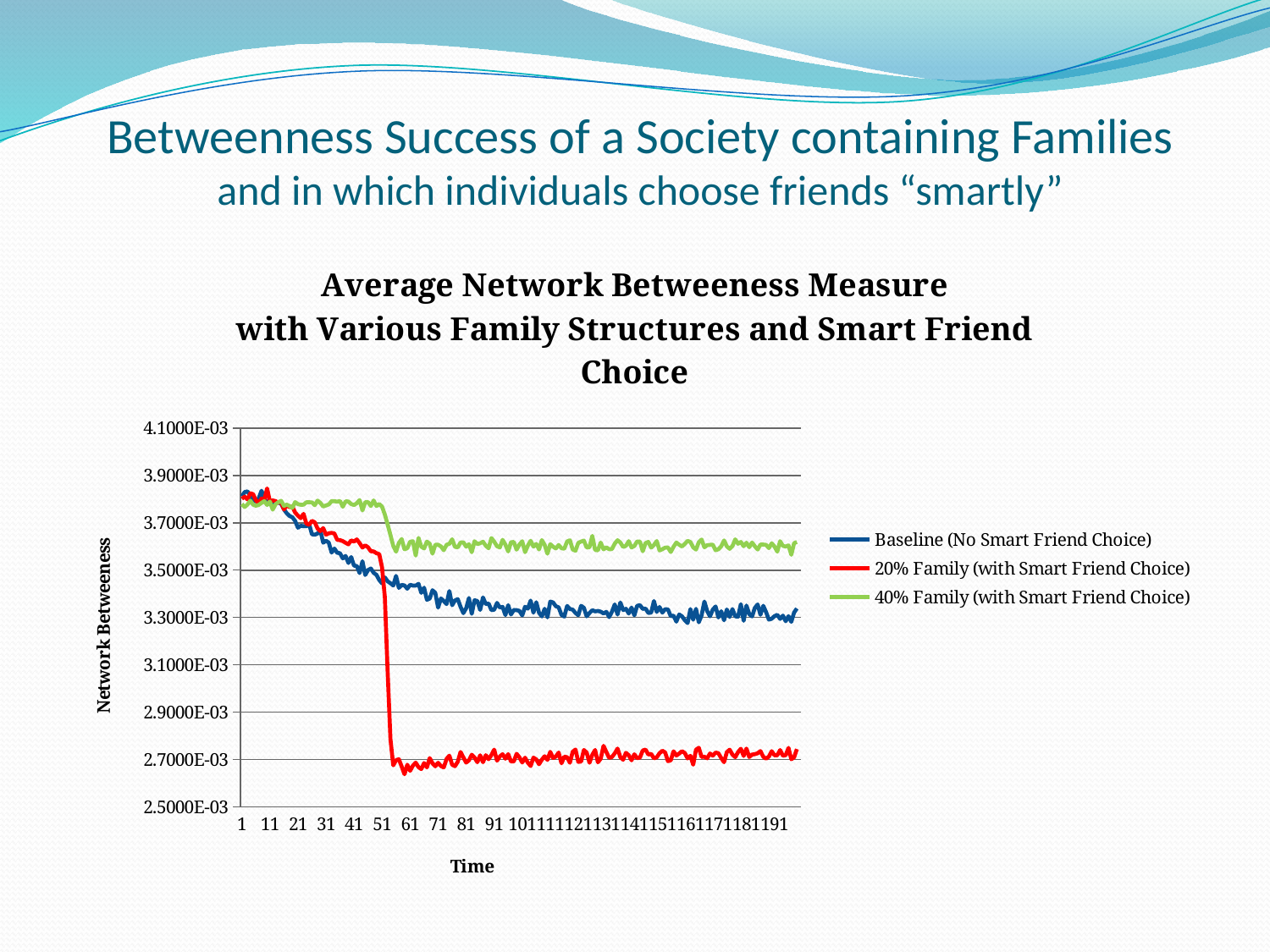
At time 191, which is larger: the value for Baseline (No Smart Friend Choice) or the value for 20% Family (with Smart Friend Choice)? Baseline (No Smart Friend Choice) Which series has the lowest values at time 191? 20% Family (with Smart Friend Choice) How many series does the legend list? 3 Is the value for Baseline (No Smart Friend Choice) at time 191 greater or less than 3.5000E-03? less Is the value for 40% Family (with Smart Friend Choice) at time 191 greater or less than 3.5000E-03? greater Which series has the highest values at time 191? 40% Family (with Smart Friend Choice) What is the label of the vertical axis? Network Betweeness Does the Baseline (No Smart Friend Choice) series rise or fall along the x axis? fall What is the highest tick value shown on the vertical axis? 4.1000E-03 What kind of chart is shown on the slide? line chart Is the value for 20% Family (with Smart Friend Choice) at time 101 greater or less than 2.9000E-03? less What is the title of the chart? Average Network Betweeness Measure with Various Family Structures and Smart Friend Choice